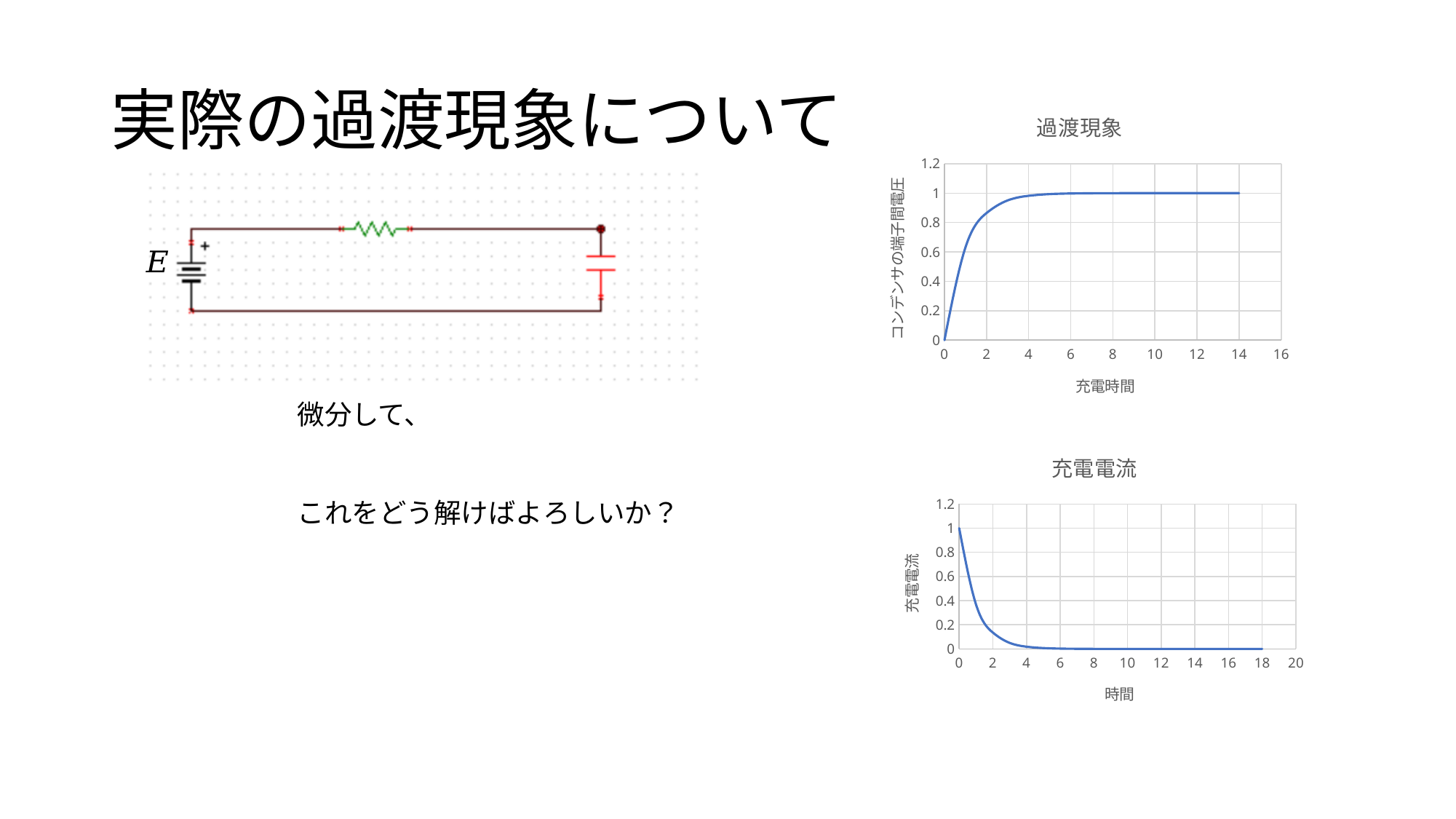
In the chart titled 過渡現象, is the value at 充電時間 = 4 greater or less than 0.8? greater What kind of chart is the chart titled 過渡現象? line chart In the chart titled 過渡現象, do the values rise or fall as 充電時間 increases? rise In the chart titled 充電電流, is the value at 時間 = 10 greater or less than 0.2? less What is the y-axis label of the chart titled 過渡現象? コンデンサの端子間電圧 In the chart titled 充電電流, what is the value at 時間 = 0? 1 What kind of chart is the chart titled 充電電流? line chart In the chart titled 過渡現象, what is the value at 充電時間 = 0? 0 In the chart titled 過渡現象, is the value at 充電時間 = 10 greater or less than 0.8? greater What is the x-axis label of the chart titled 充電電流? 時間 In the chart titled 充電電流, do the values rise or fall as 時間 increases? fall